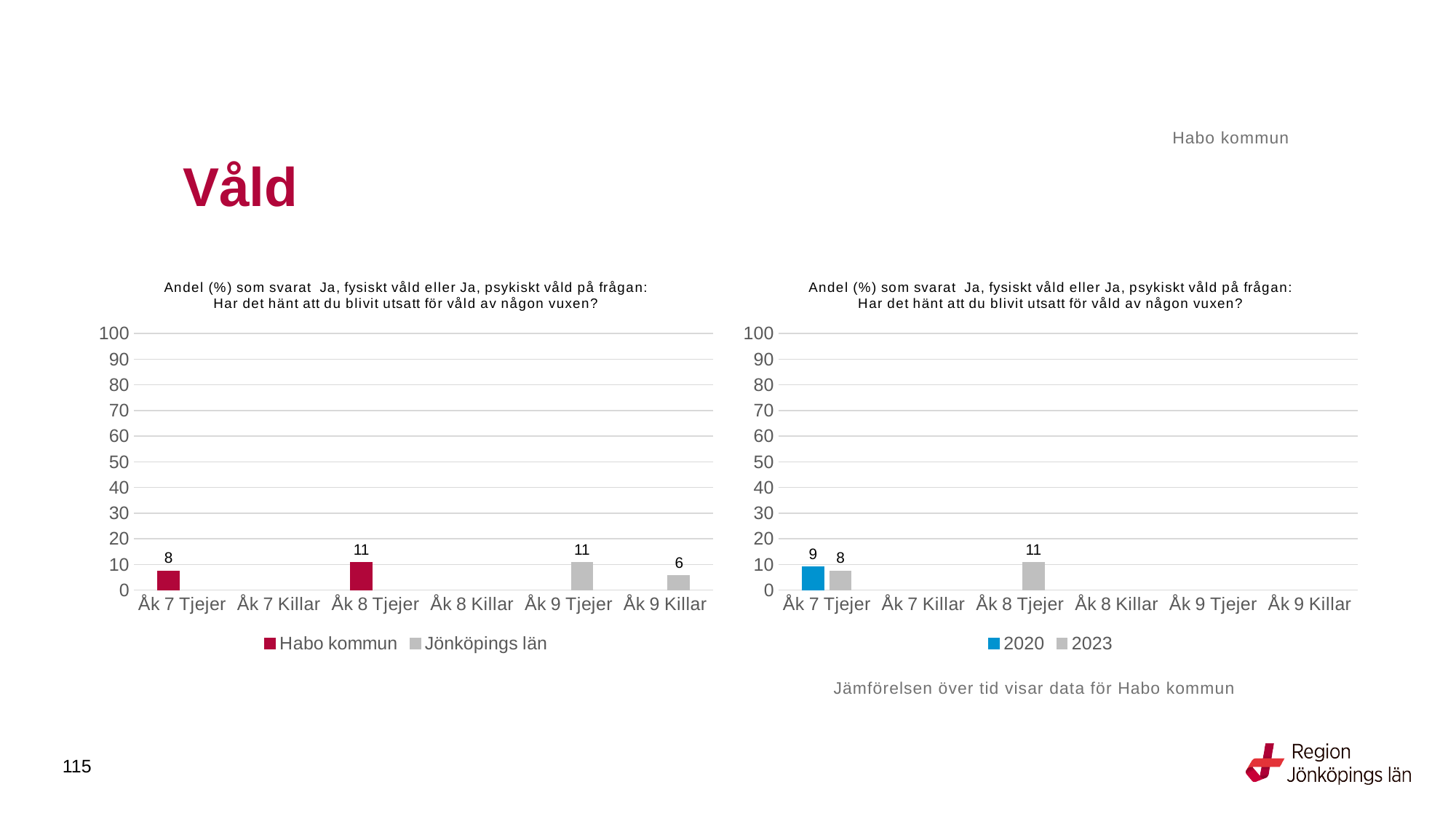
In the left chart, what is the difference between the Habo kommun value for Åk 8 Tjejer and the Habo kommun value for Åk 7 Tjejer? 3 What kind of chart is the left chart? bar chart In the right chart, what is the value for 2020 for Åk 7 Tjejer? 9 In the left chart, how many series does the legend list? 2 In the left chart, what is the value for Jönköpings län for Åk 9 Tjejer? 11 In the right chart, is the 2023 value for Åk 8 Tjejer greater or less than 20? less In the left chart, what is the value for Habo kommun for Åk 7 Tjejer? 8 In the right chart, what is the value for 2023 for Åk 7 Tjejer? 8 In the left chart, what is the value for Jönköpings län for Åk 9 Killar? 6 In the left chart, what is the value for Habo kommun for Åk 8 Tjejer? 11 In the right chart, what is the value for 2023 for Åk 8 Tjejer? 11 In the right chart, which is larger for Åk 7 Tjejer: the 2020 value or the 2023 value? 2020